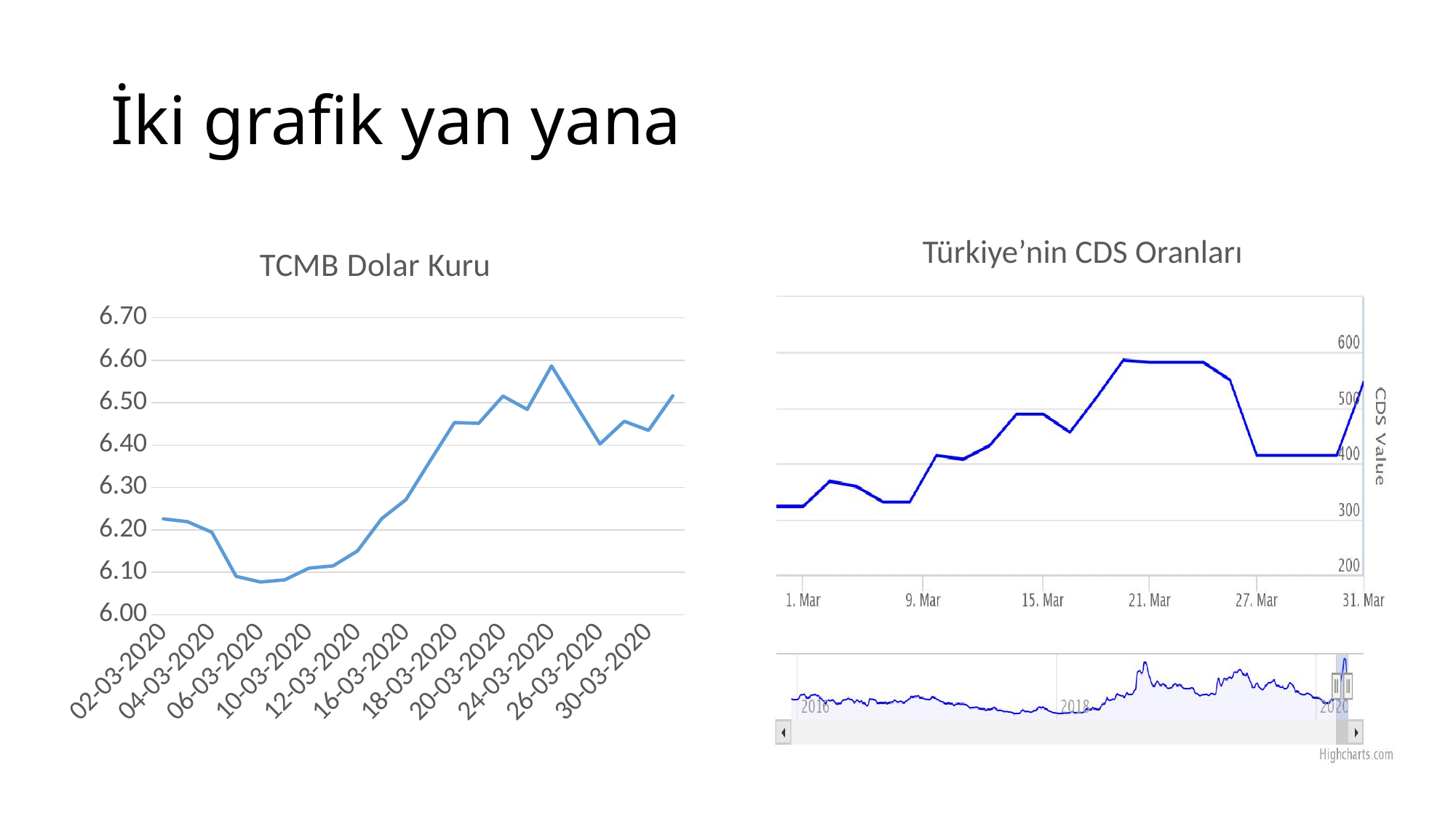
What is the title of the chart on the left of the slide? TCMB Dolar Kuru In the TCMB Dolar Kuru chart, is the value for 06-03-2020 greater or less than 6.20? less In the TCMB Dolar Kuru chart, is the value for 24-03-2020 greater or less than 6.50? greater In the TCMB Dolar Kuru chart, is the value for 30-03-2020 greater or less than 6.40? greater What kind of chart is the Türkiye'nin CDS Oranları chart? line chart What kind of chart is the TCMB Dolar Kuru chart? line chart What is the y-axis title of the Türkiye'nin CDS Oranları chart? CDS Value In the Türkiye'nin CDS Oranları chart, is the value for 1. Mar larger or smaller than the value for 31. Mar? smaller In the TCMB Dolar Kuru chart, is the value for 02-03-2020 larger or smaller than the value for 30-03-2020? smaller In the TCMB Dolar Kuru chart, do the values overall rise or fall from 02-03-2020 to 30-03-2020? rise